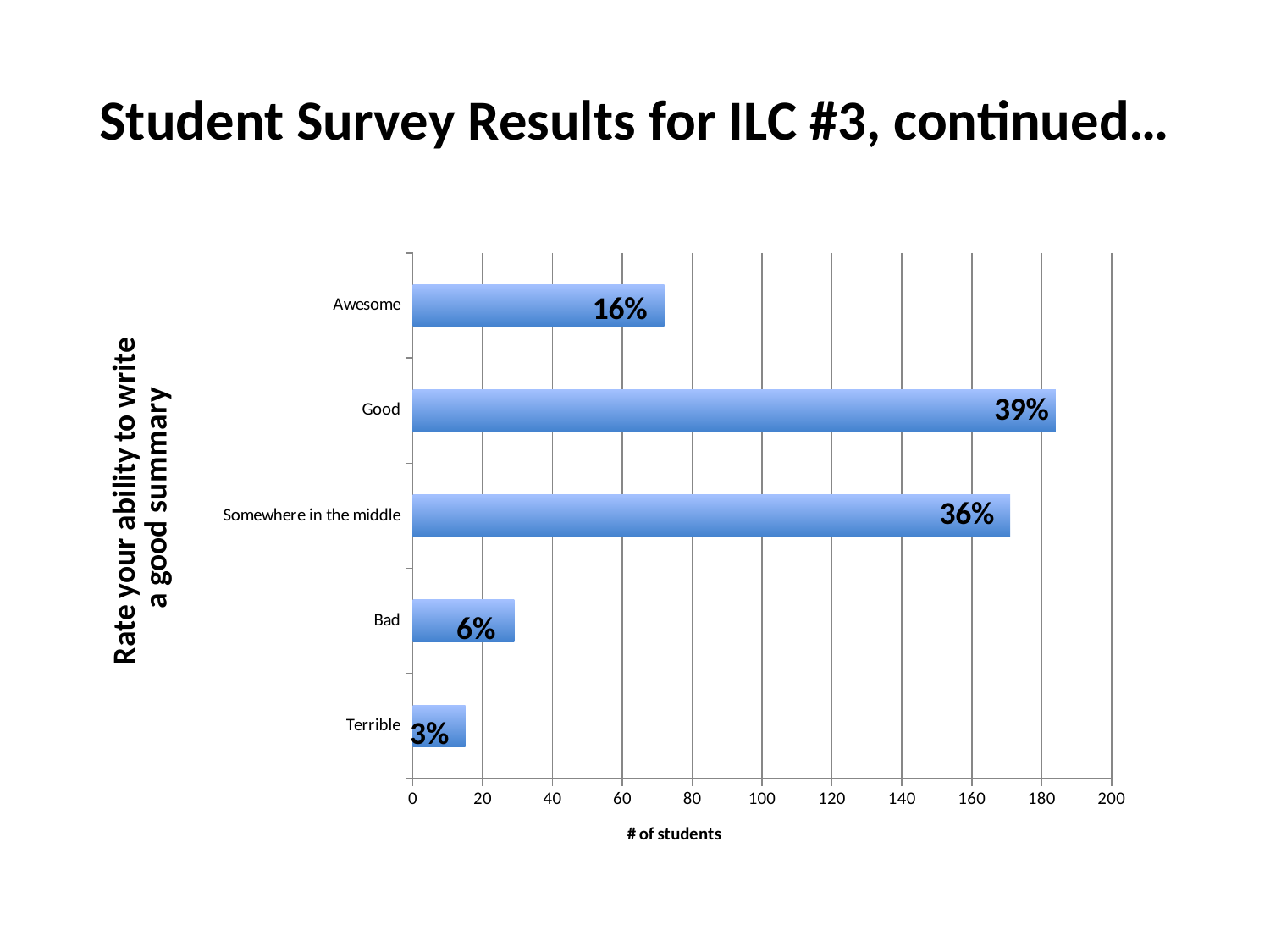
Which rating category has the lowest value? Terrible By how many percentage points does "Good" exceed "Somewhere in the middle"? 3 percentage points How many rating categories are shown on the chart? 5 What percentage label is shown on the bar for "Somewhere in the middle"? 36% Is the number of students for "Bad" greater or less than 40? less Which has a larger value, "Awesome" or "Bad"? Awesome What percentage label is shown on the bar for "Terrible"? 3% What percentage label is shown on the bar for "Good"? 39% Which rating category has the highest value? Good What type of chart is shown on the slide? Bar chart What is the title of the horizontal axis of the chart? # of students Is the number of students for "Awesome" greater or less than 60? greater